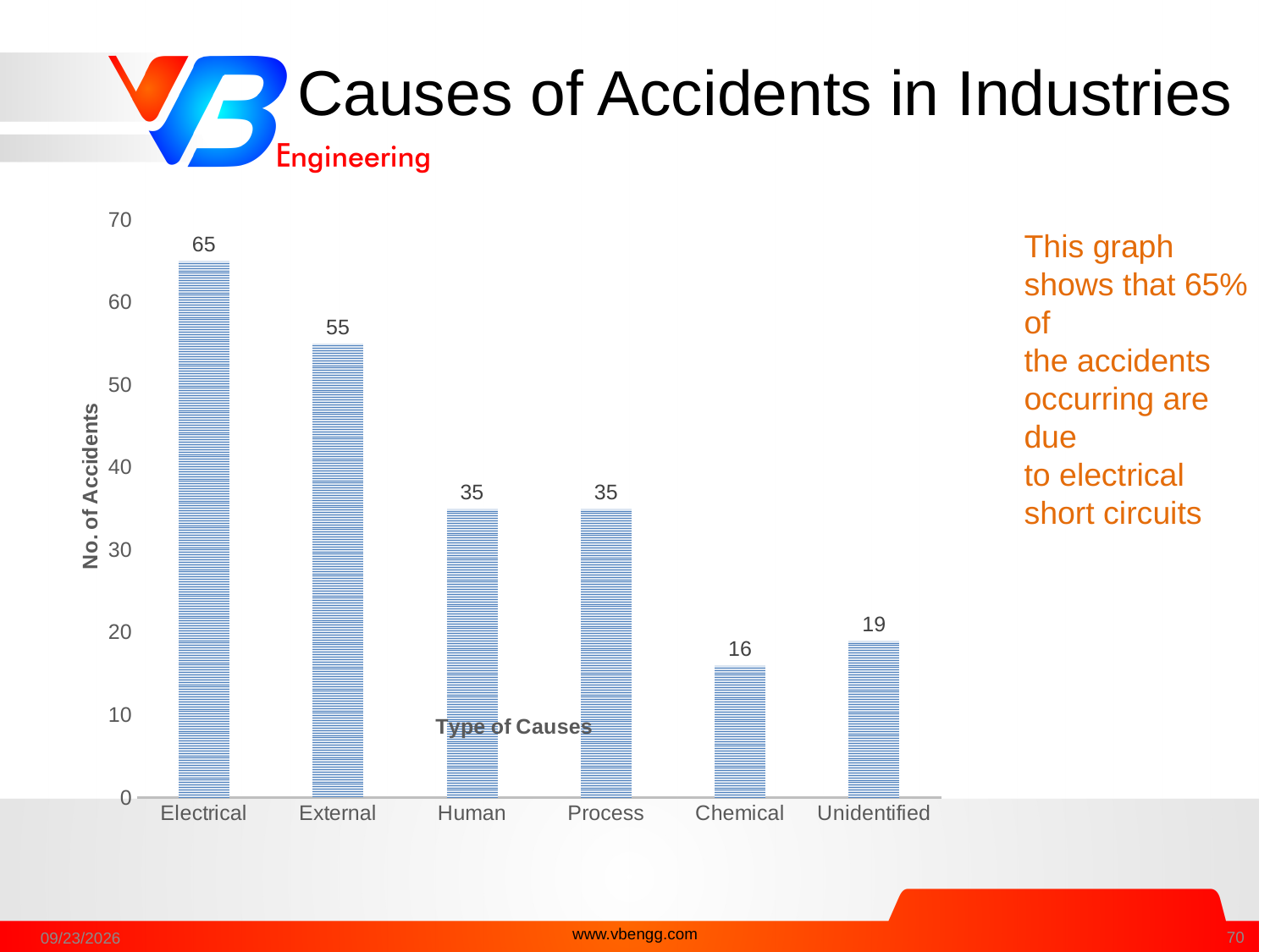
Which has more accidents, External or Human causes? External Is the value for Process greater or less than 40? less What is the number of accidents for Unidentified causes? 19 What is the difference in the number of accidents between Electrical and External causes? 10 Which type of cause has the lowest number of accidents? Chemical How many types of causes are shown on the x axis? 6 What is the number of accidents for Electrical causes? 65 What is the difference in the number of accidents between Unidentified and Chemical causes? 3 What kind of chart is shown on the slide? Bar chart What is the label of the vertical axis? No. of Accidents What is the number of accidents for Chemical causes? 16 Which type of cause has the highest number of accidents? Electrical